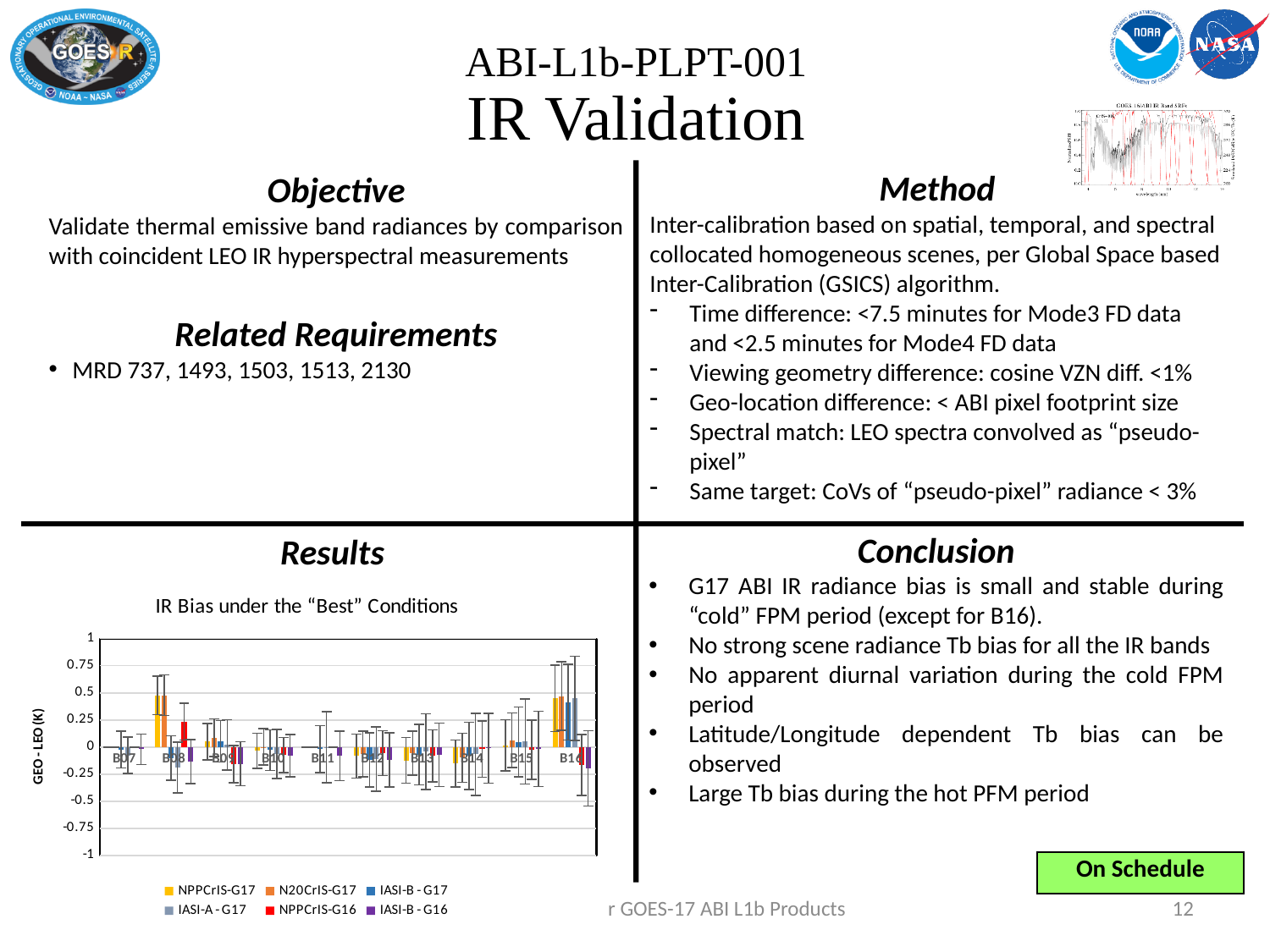
In the IR Bias chart, is the IASI-B - G16 value for B16 greater or less than 0? less What kind of chart is shown under Results? bar chart What is the y-axis label of the IR Bias chart? GEO - LEO (K) In the IR Bias chart, is the NPPCrIS-G16 value for B08 greater or less than 0? greater How many series does the legend of the IR Bias chart list? 6 In the IR Bias chart, is the NPPCrIS-G17 value for B08 greater or less than 0.25? greater In the IR Bias chart, which is larger for B16: the NPPCrIS-G17 value or the IASI-B - G16 value? NPPCrIS-G17 How many band categories are shown on the x axis of the IR Bias chart? 10 What is the title of the chart under Results? IR Bias under the "Best" Conditions